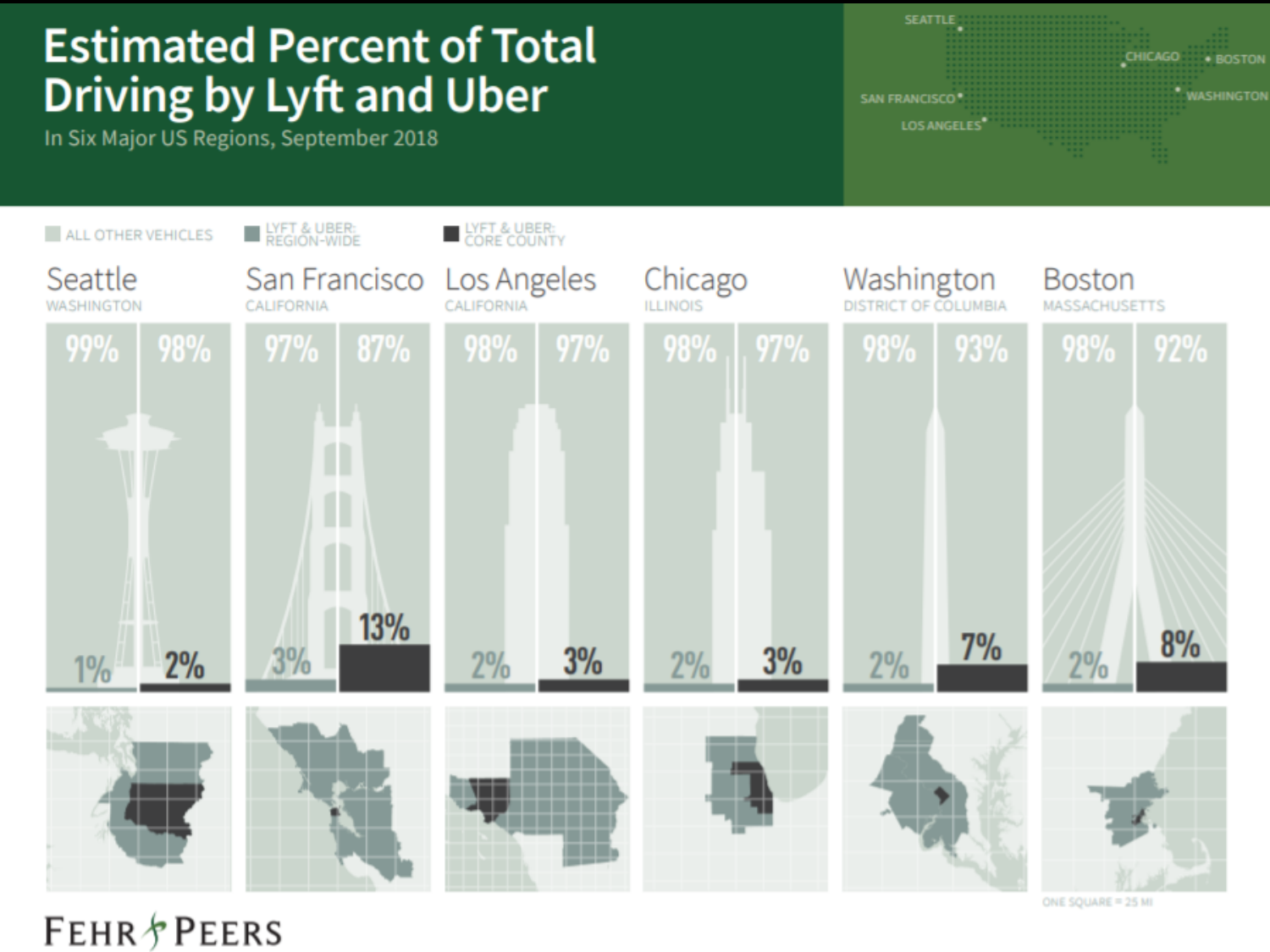
What is the region-wide percent of driving by Lyft and Uber in Seattle? 1% What is the total of the core-county bar for Chicago (all other vehicles plus Lyft and Uber)? 100% What is the difference between the core-county and region-wide Lyft and Uber percentages for Boston? 6% Which region has the lowest region-wide percent of driving by Lyft and Uber? Seattle How many entries does the legend list? 3 How many regions are shown on the slide? 6 Which region has the highest core-county percent of driving by Lyft and Uber? San Francisco What is the title of the chart? Estimated Percent of Total Driving by Lyft and Uber What kind of chart is used to show the driving percentages for each region? Stacked bar chart Which is larger: the core-county Lyft and Uber share in Washington or in Boston? Boston What percent of total driving in the core county of Washington, District of Columbia, is by all other vehicles? 93% What is the estimated percent of total driving by Lyft and Uber in the core county of San Francisco? 13%